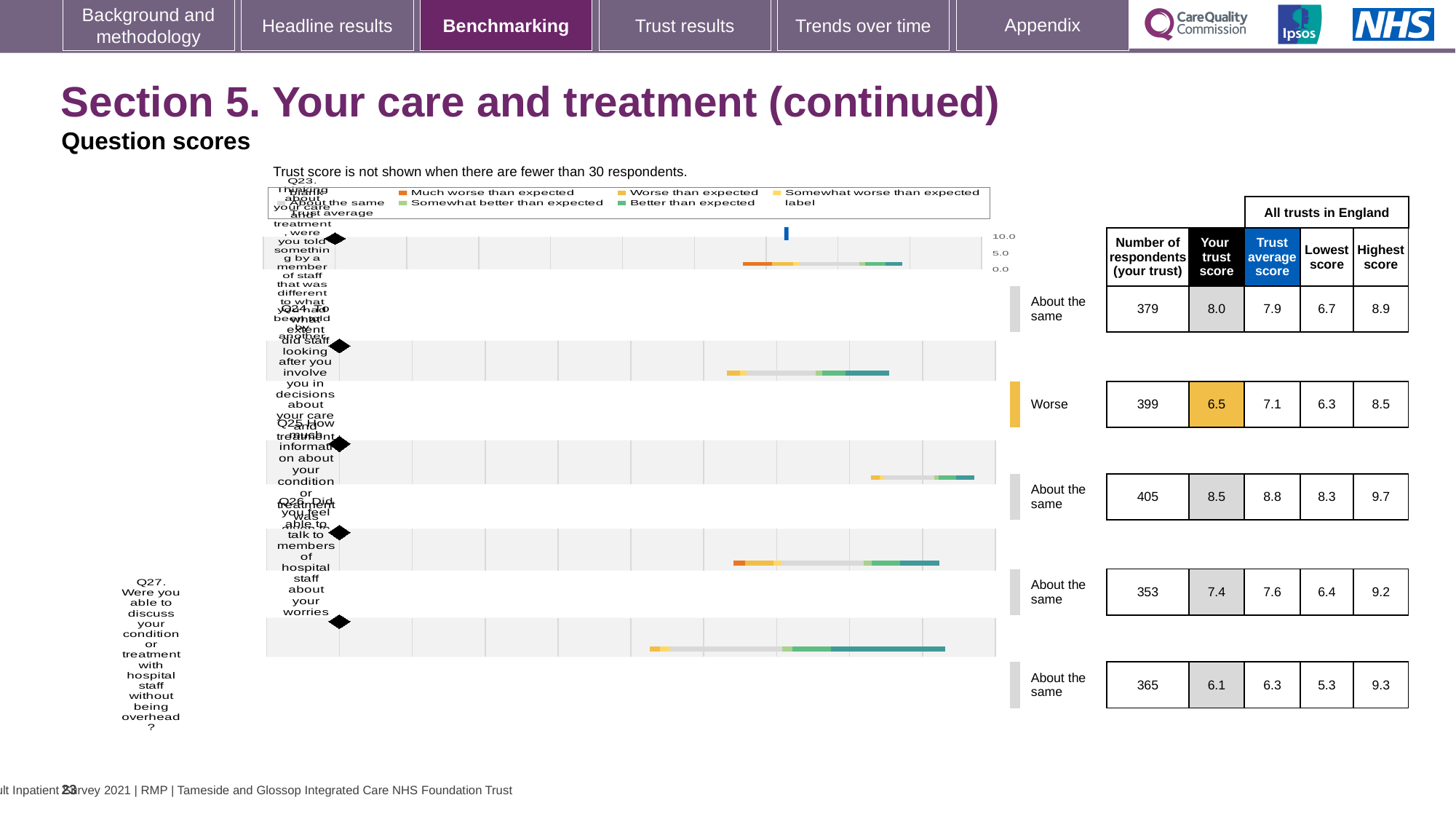
Which question is rated 'Worse' compared with other trusts? Q24 What is the difference between the highest score and the lowest score across all trusts in England for Q27? 4.0 What is the highest score among all trusts in England for Q25? 9.7 Is the trust score for Q23 higher or lower than the trust average score for Q23? higher How many respondents from the trust answered Q25? 405 Which question has the highest 'Your trust score'? Q25 What type of chart is used to show the question scores? bar chart Which question has the lowest 'Your trust score'? Q27 What is the trust average score for Q27 (discussing your condition or treatment without being overheard)? 6.3 What is the trust score for Q24 (to what extent did staff looking after you involve you in decisions about your care and treatment)? 6.5 How many questions are shown on this slide? 5 What colour is the legend entry for 'Much worse than expected'? orange